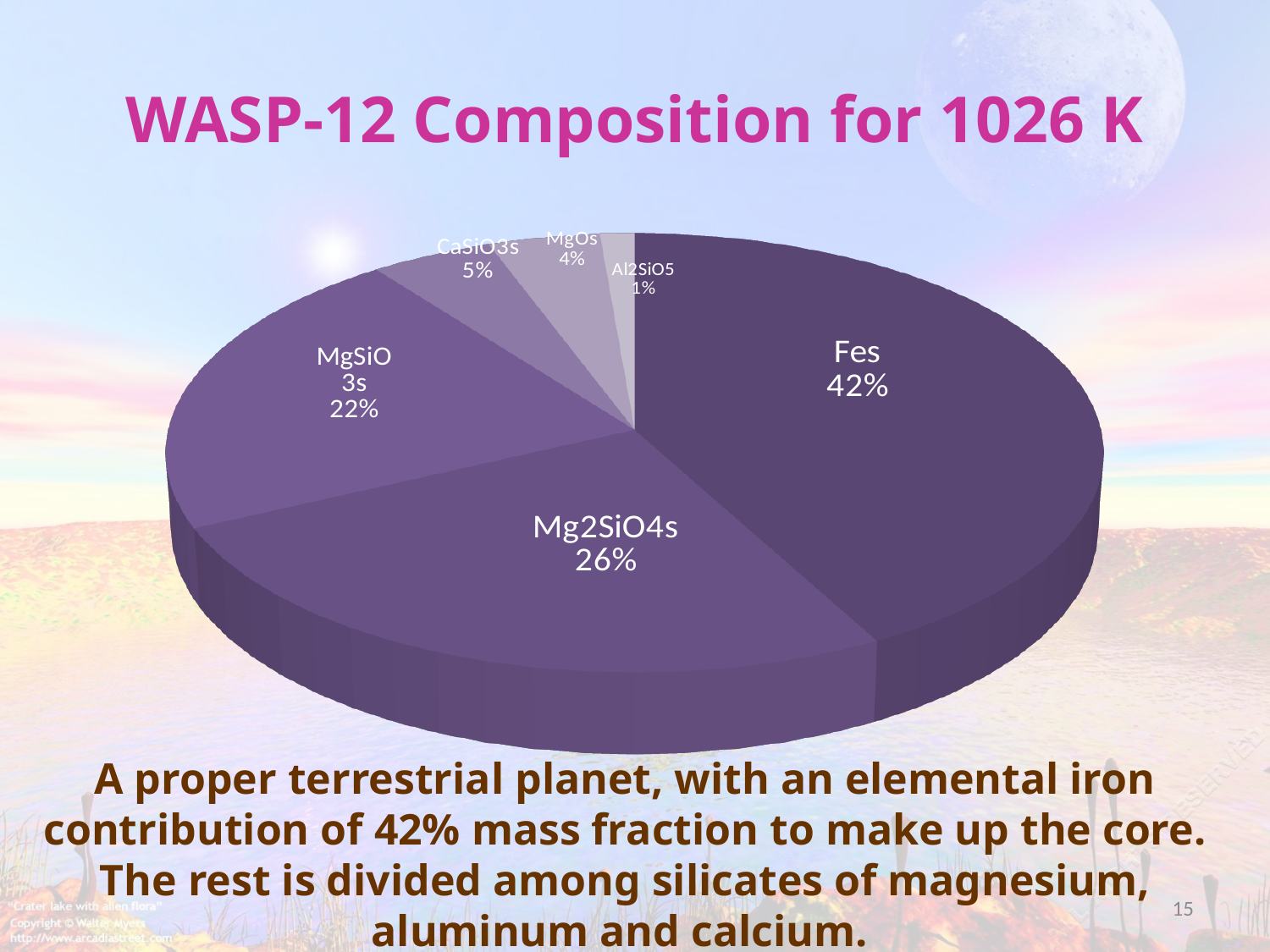
Which has a larger share, MgSiO3s or Mg2SiO4s? Mg2SiO4s Which component has the largest share of the pie? Fes What is the title of the chart? WASP-12 Composition for 1026 K What percentage is shown for Al2SiO5? 1% What percentage is shown for Mg2SiO4s? 26% Which component has the smallest share of the pie? Al2SiO5 How many slices does the pie chart have? 6 What is the difference in percentage points between Fes and Mg2SiO4s? 16 What kind of chart is shown on the slide? pie chart What percentage is shown for MgSiO3s? 22% What percentage is shown for CaSiO3s? 5% What percentage of the pie does Fes account for? 42%